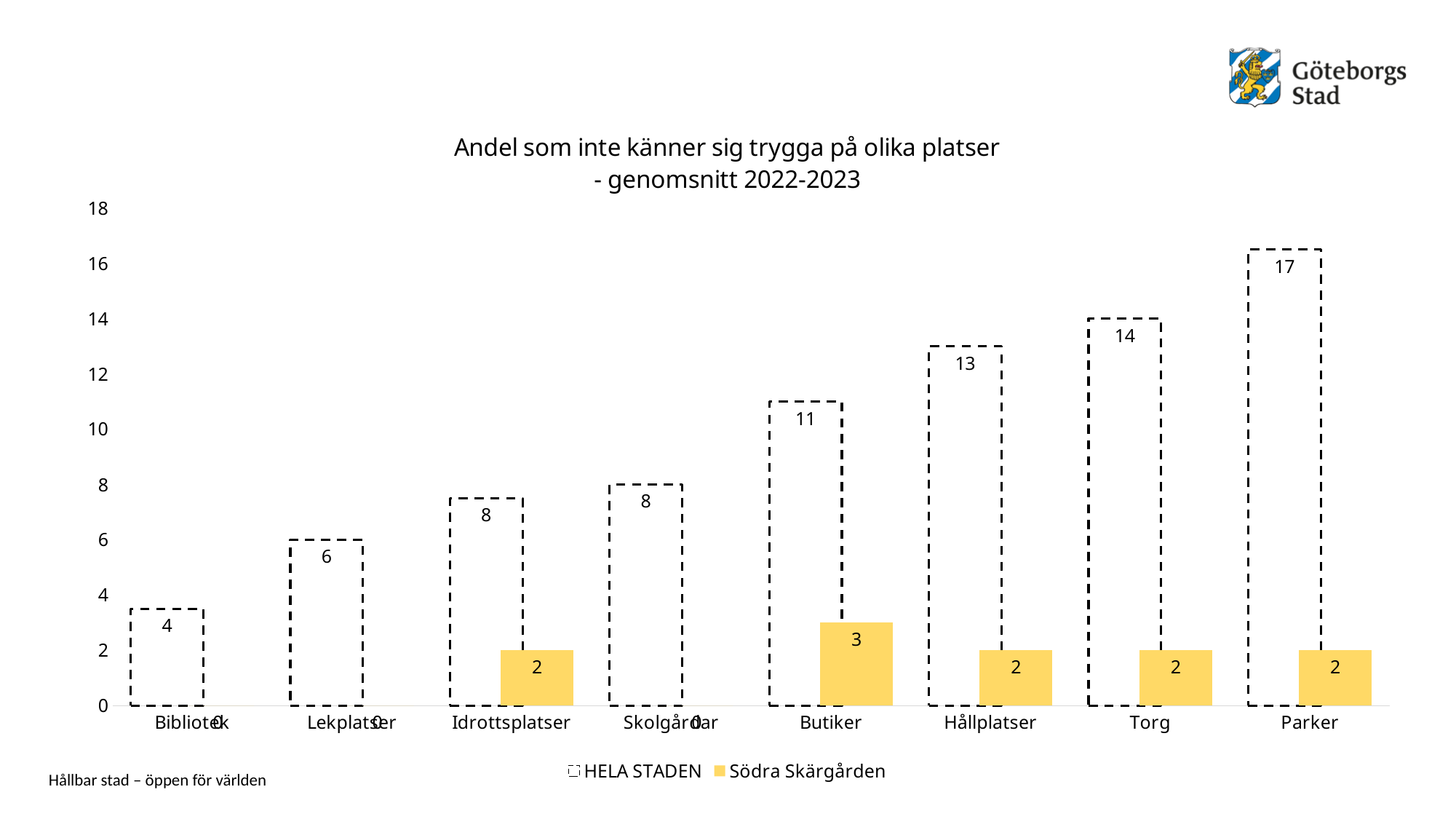
Do the HELA STADEN values rise or fall from Bibliotek to Parker? Rise How many series does the legend list? 2 What is the value for Södra Skärgården at Butiker? 3 Which category has the lowest value for HELA STADEN? Bibliotek What is the value for HELA STADEN at Parker? 17 What kind of chart is shown on the slide? Bar chart Which is larger at Butiker: the HELA STADEN value or the Södra Skärgården value? HELA STADEN Which category has the highest value for HELA STADEN? Parker What is the value for HELA STADEN at Hållplatser? 13 Which series is drawn with yellow filled bars? Södra Skärgården How many categories are shown on the x axis? 8 What is the difference between the HELA STADEN value and the Södra Skärgården value at Torg? 12